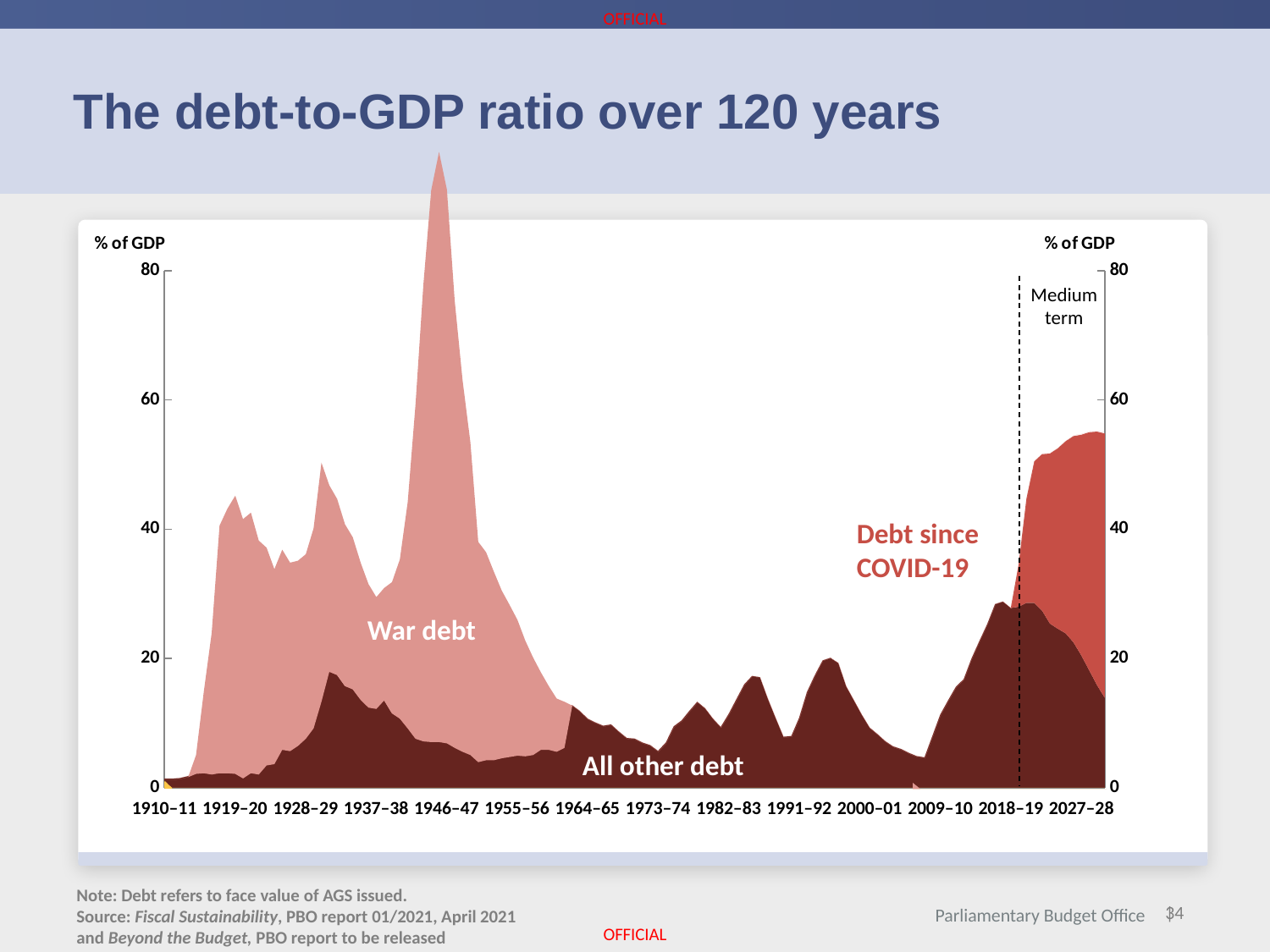
Is the peak of War debt around 1946–47 greater or less than 60% of GDP? greater How many year labels are shown along the x axis? 14 Is the total debt-to-GDP ratio at 2027–28 greater or less than 40? greater Is the All other debt value around 1937–38 greater or less than 20? less What is the title of the slide's chart? The debt-to-GDP ratio over 120 years What unit is shown on the vertical axis of the chart? % of GDP How many debt categories are labelled in the chart? 3 Does the total debt-to-GDP ratio rise or fall between 2009–10 and 2027–28? rise Which is larger: the War debt peak around 1946–47 or the total debt at 2027–28? War debt peak around 1946–47 What kind of chart is shown on the slide? Area chart